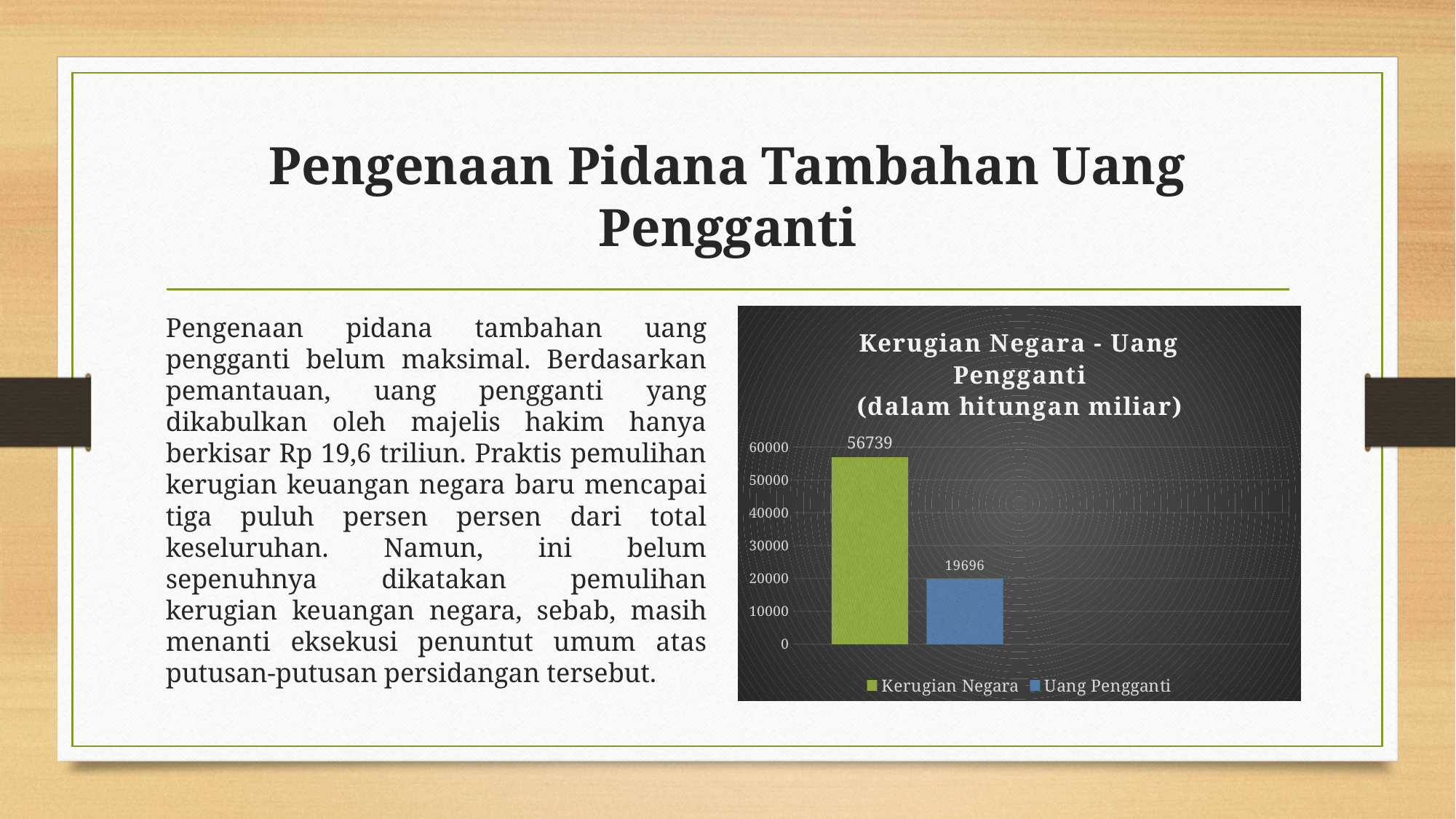
What is the value for Kerugian Negara in the chart? 56739 What is the value for Uang Pengganti in the chart? 19696 What colour is the bar for Uang Pengganti? blue What is the difference between the Kerugian Negara value and the Uang Pengganti value? 37043 What kind of chart is shown on the slide? bar chart Is the value for Uang Pengganti greater or less than 30000? less Which series has the lowest value in the chart? Uang Pengganti How many series does the legend list? 2 Which is larger, Kerugian Negara or Uang Pengganti? Kerugian Negara Is the value for Kerugian Negara greater or less than 50000? greater What is the title of the chart? Kerugian Negara - Uang Pengganti (dalam hitungan miliar) Which series has the highest value in the chart? Kerugian Negara